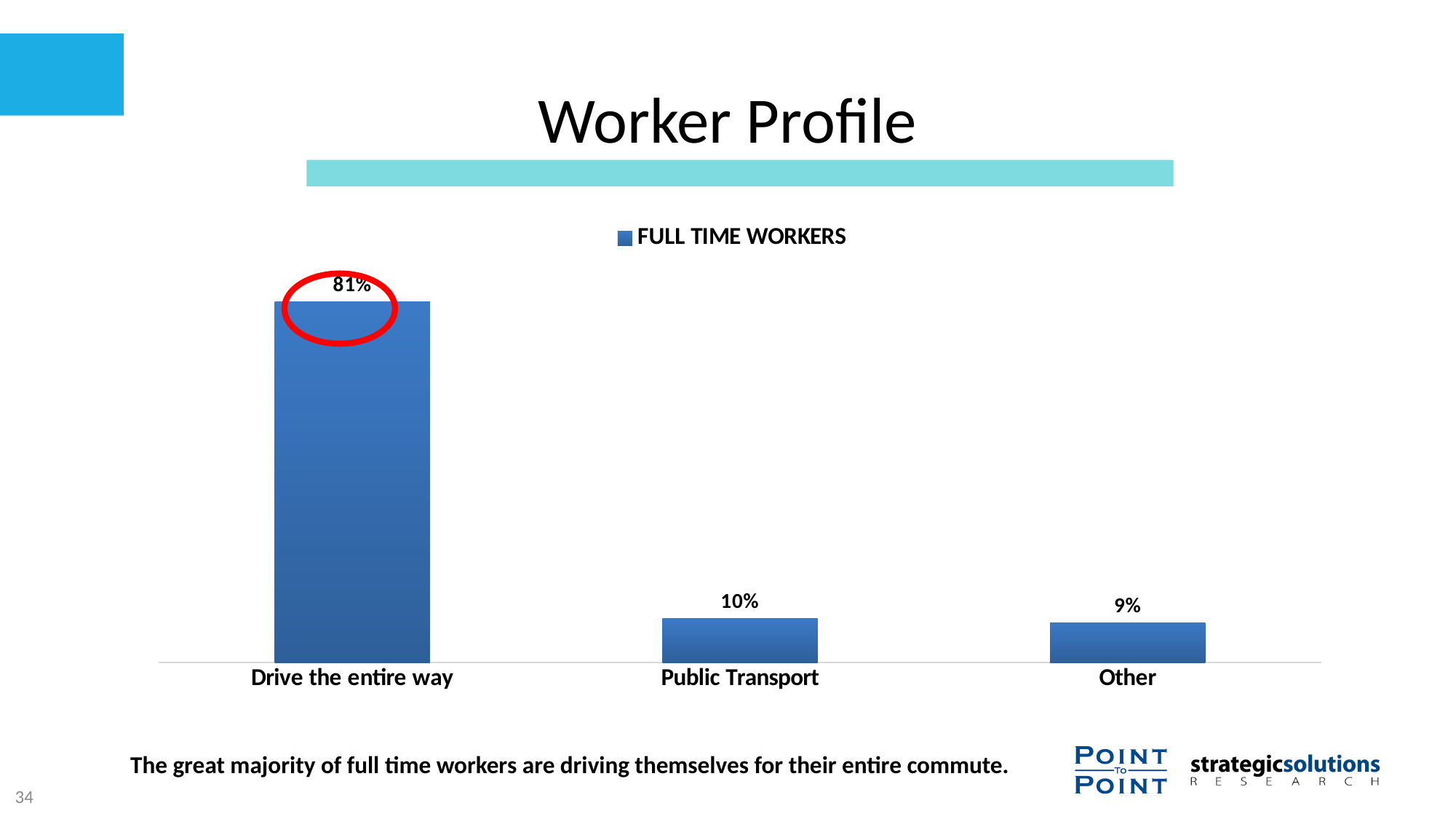
What kind of chart is shown on the slide? Bar chart What is the value for Public Transport? 10% What is the value for Other? 9% What is the name of the series in the legend? FULL TIME WORKERS How many series does the legend list? 1 What is the difference between the values for Drive the entire way and Public Transport? 71% What is the difference between the values for Public Transport and Other? 1% How many categories are shown on the x axis? 3 Which is larger, the value for Drive the entire way or the value for Other? Drive the entire way Which category has the lowest value? Other What percentage of full time workers drive the entire way? 81% Which category has the highest value? Drive the entire way